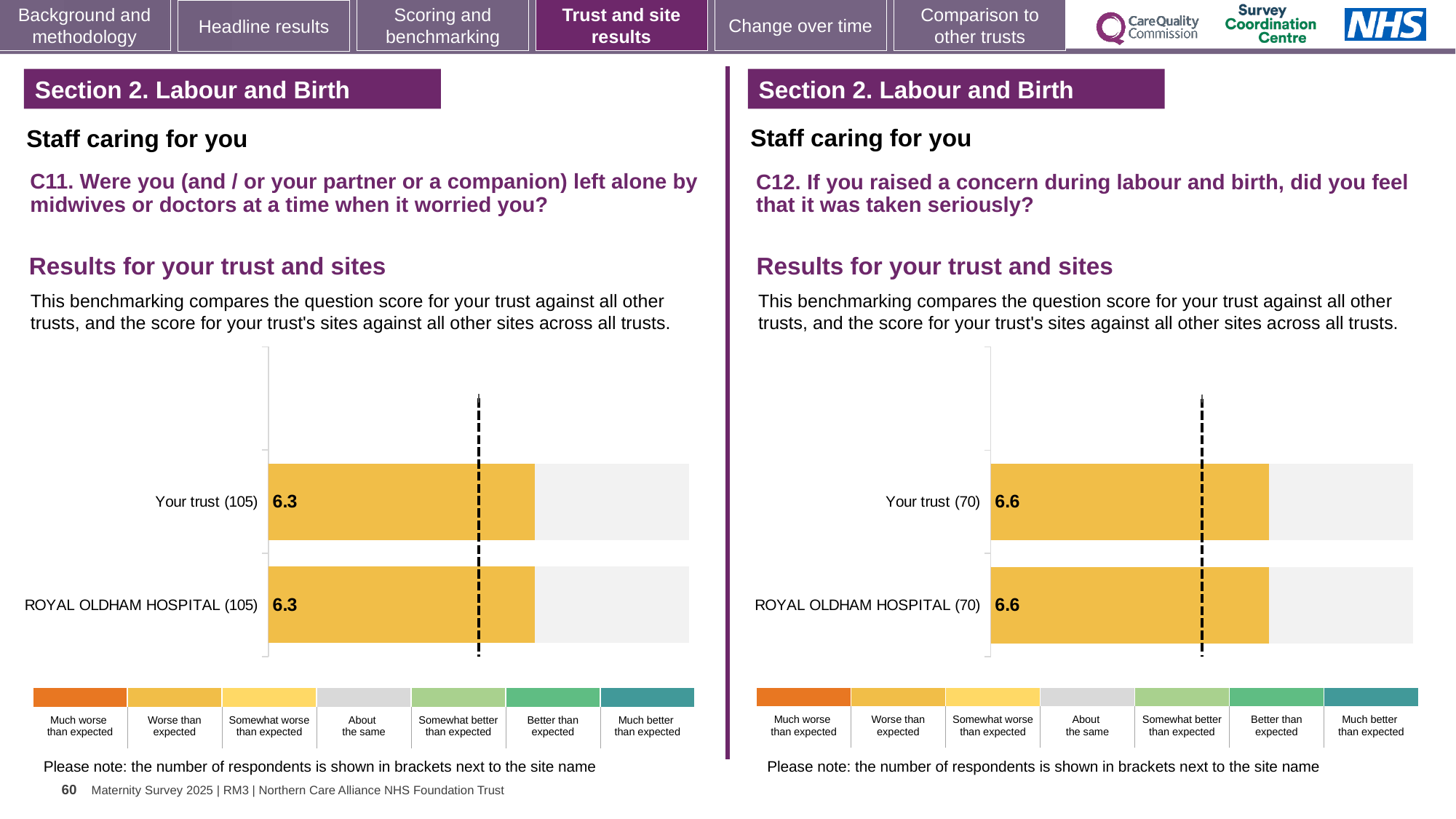
In the C11 chart on the left, what is the difference between the score for Your trust and the score for ROYAL OLDHAM HOSPITAL? 0 In the C11 chart on the left, how many respondents are shown in brackets for Your trust? 105 In the C11 chart on the left, what is the score for Your trust? 6.3 What kind of chart is used in the C11 chart on the left? Bar chart How many bars are plotted in the C11 chart on the left? 2 In the C12 chart on the right, what is the score for Your trust? 6.6 In the C11 chart on the left, what is the score for ROYAL OLDHAM HOSPITAL? 6.3 Is the score for Your trust in the C12 chart on the right larger than the score for Your trust in the C11 chart on the left? Yes How many bars are plotted in the C12 chart on the right? 2 In the C12 chart on the right, what is the score for ROYAL OLDHAM HOSPITAL? 6.6 In the C12 chart on the right, how many respondents are shown in brackets for ROYAL OLDHAM HOSPITAL? 70 In the C12 chart on the right, what is the difference between the score for Your trust and the score for ROYAL OLDHAM HOSPITAL? 0